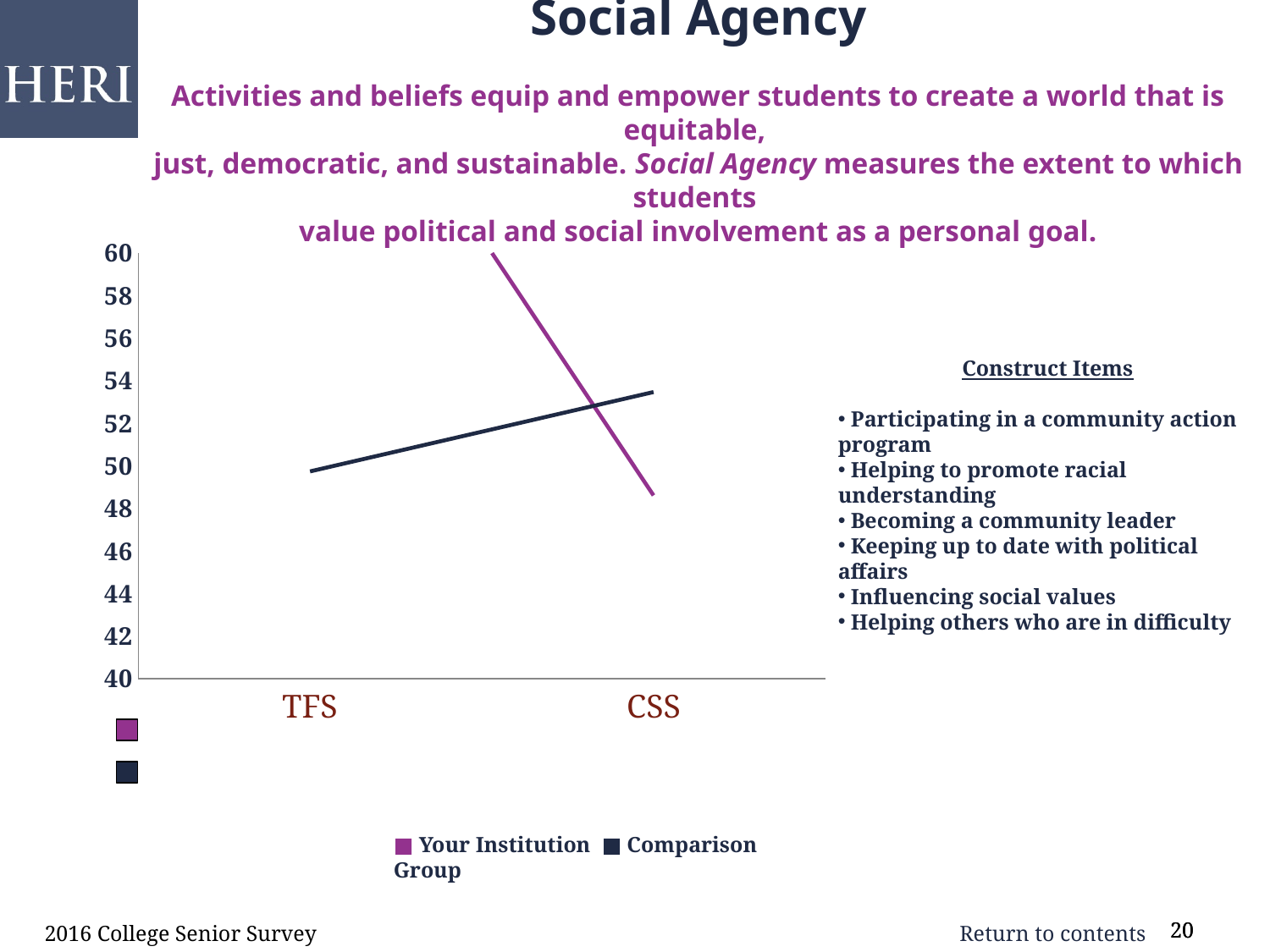
How many series does the legend list? 2 At TFS, which series has the higher value, Your Institution or Comparison Group? Your Institution Is the value for Comparison Group at TFS greater or less than 52? less Does the Your Institution line rise or fall from TFS to CSS? fall Is the value for Your Institution at CSS greater or less than 50? less What kind of chart is shown on the slide? line chart At CSS, which series has the higher value, Your Institution or Comparison Group? Comparison Group Is the value for Your Institution at TFS greater or less than 58? greater What is the title of the chart? Social Agency Does the Comparison Group line rise or fall from TFS to CSS? rise How many categories are shown on the x axis? 2